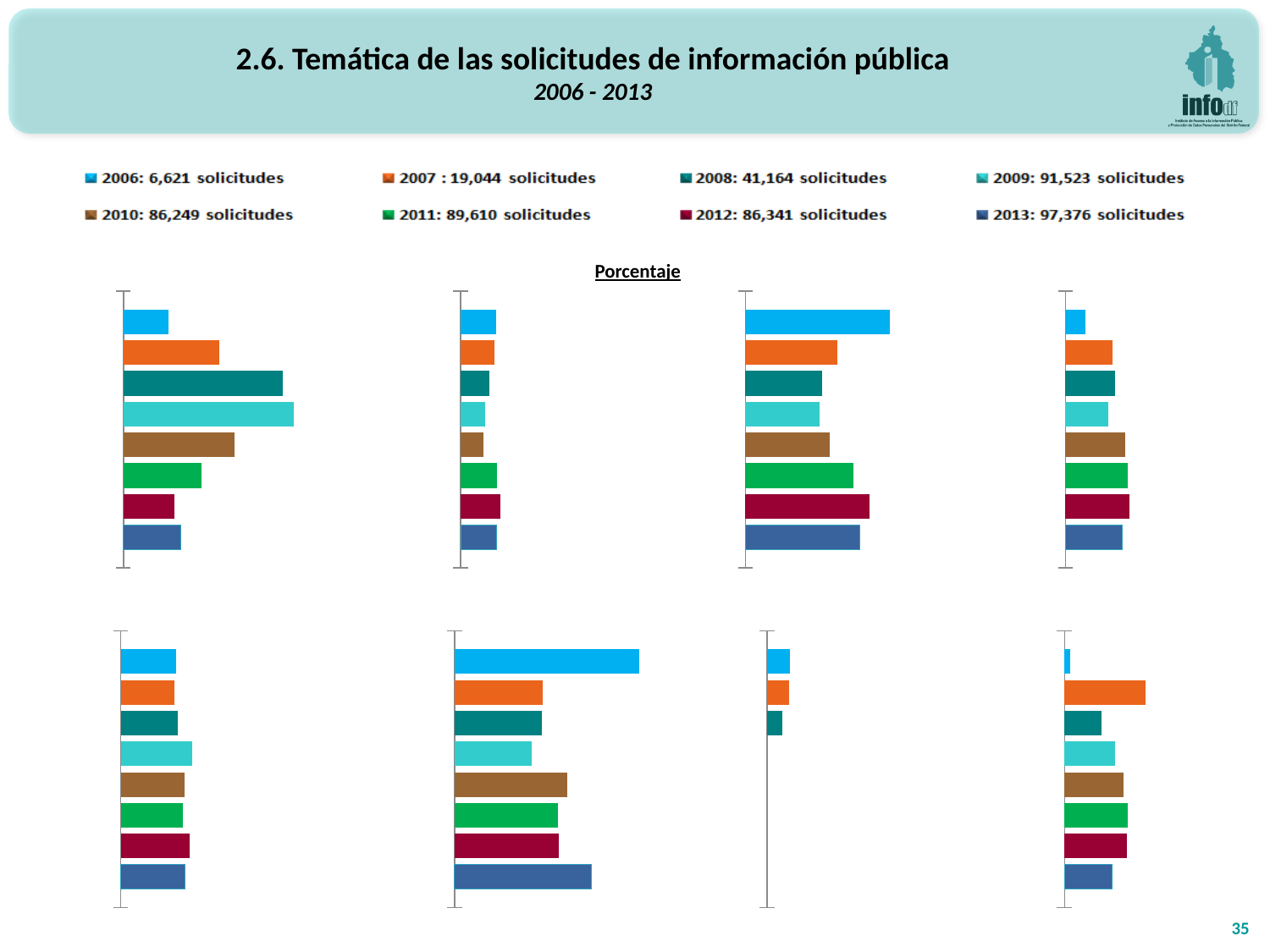
In the second chart of the bottom row, which year has the longest bar? 2006 In the top-left chart, which bar is longer, 2008 or 2007? 2008 What kind of chart is the top-left chart? bar chart According to the legend, how many solicitudes were there in 2013? 97,376 solicitudes In the fourth chart of the bottom row, which year has the longest bar? 2007 How many series does the legend list? 8 In the top-left chart, which year has the longest bar? 2009 How many bars does the top-left chart have? 8 How many bars does the third chart in the bottom row have? 3 In the fourth chart of the bottom row, which year has the shortest bar? 2006 In the top-left chart, which year has the shortest bar? 2006